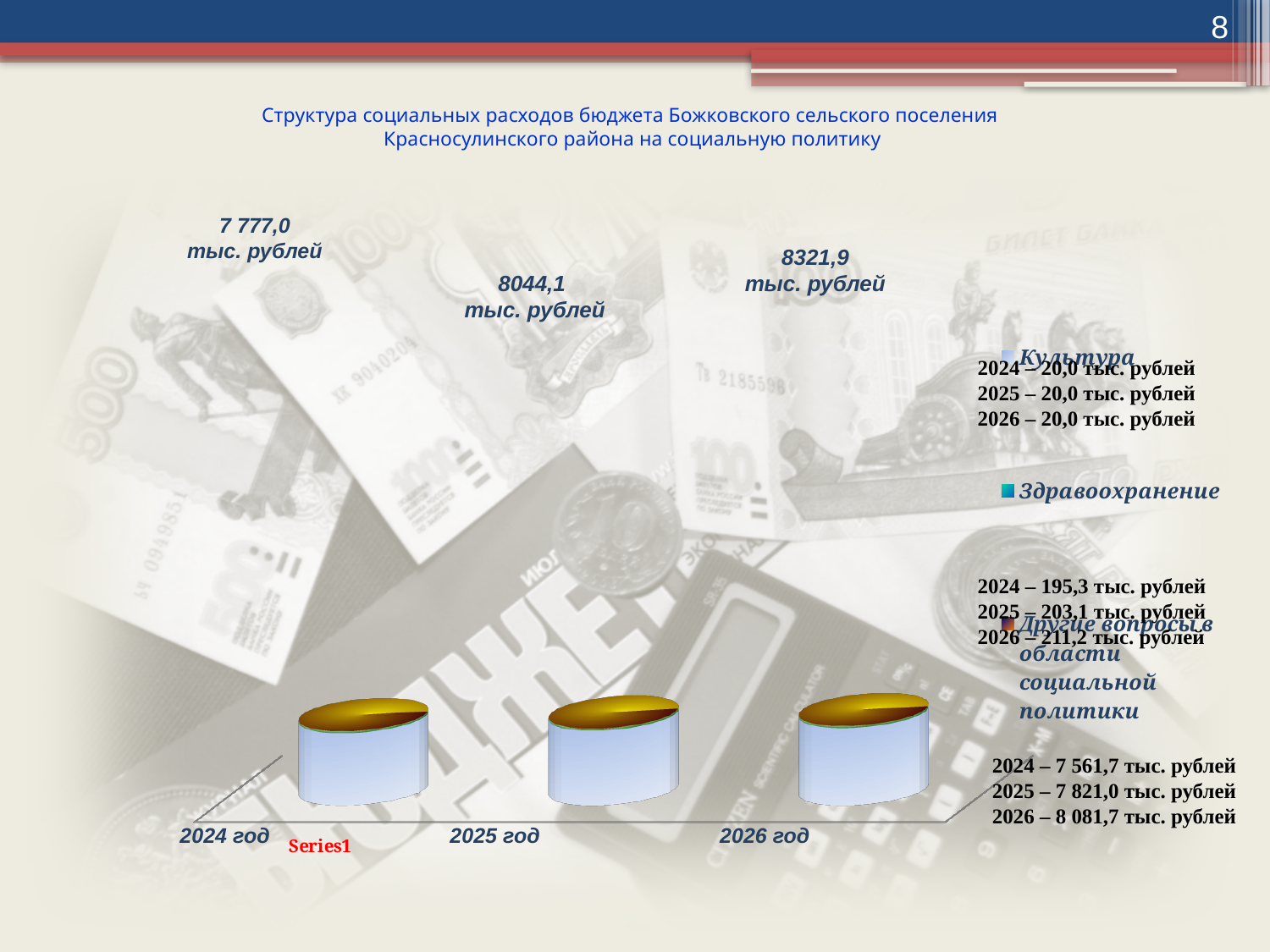
Do the total values rise or fall from 2024 год to 2026 год? Rise What is the difference between the total values shown for 2026 год and 2024 год? 544,9 тыс. рублей What total value is shown for 2025 год? 8044,1 тыс. рублей Which is larger, the total value for 2025 год or for 2024 год? 2025 год What total value is shown for 2024 год? 7 777,0 тыс. рублей What are the three entries listed in the chart legend? Культура, Здравоохранение, Другие вопросы в области социальной политики Which year has the highest total value shown? 2026 год Which year has the lowest total value shown? 2024 год What total value is shown for 2026 год? 8321,9 тыс. рублей How many series does the chart legend list? 3 How many categories (years) are shown on the x axis of the chart? 3 What kind of chart is shown on the slide? Bar chart